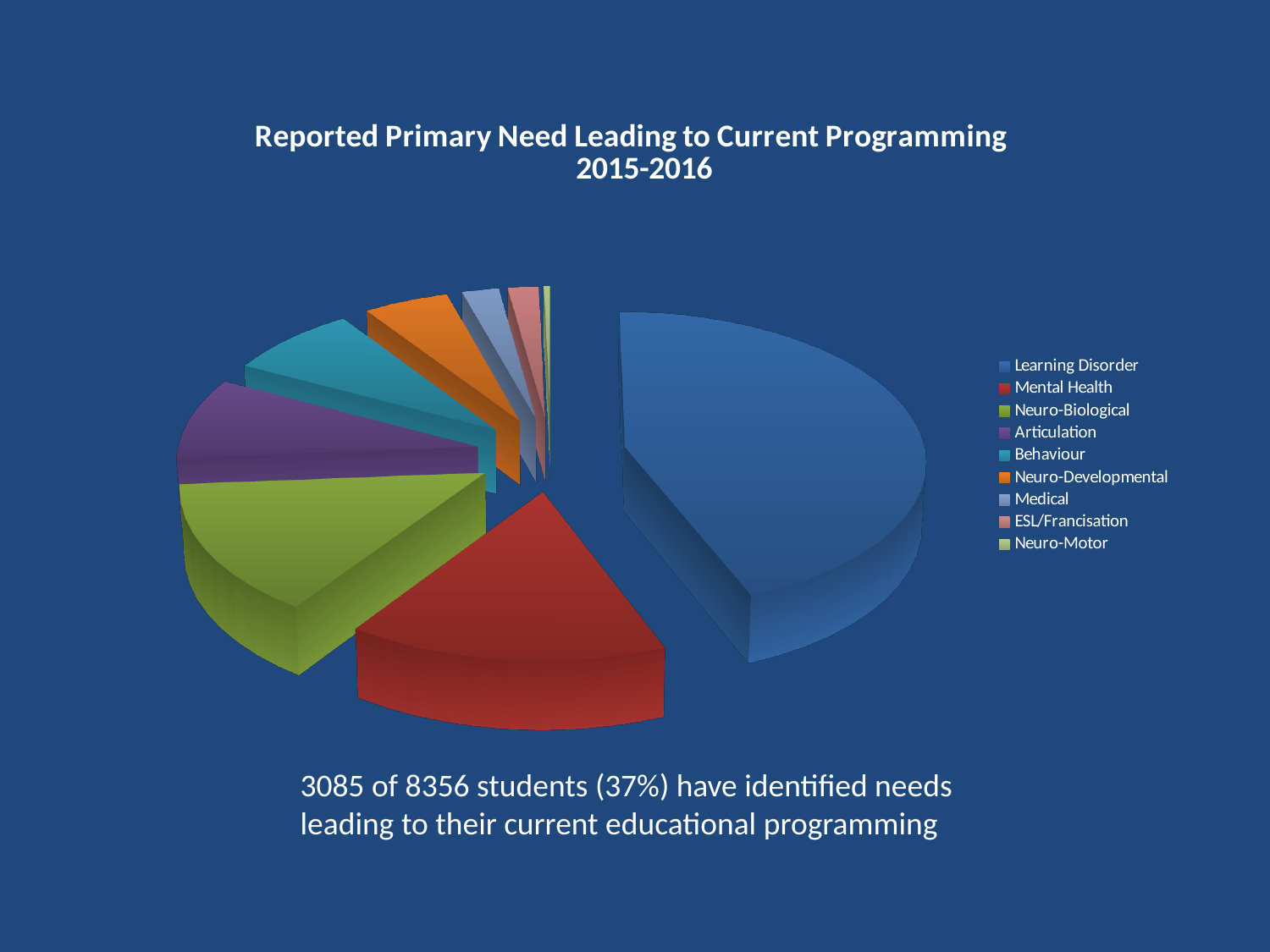
Which category has the smallest slice of the pie? Neuro-Motor Which slice is larger, Learning Disorder or Mental Health? Learning Disorder What kind of chart is shown on the slide? pie chart Which category has the largest slice of the pie? Learning Disorder Which slice is larger, Behaviour or Neuro-Motor? Behaviour Which slice is larger, Neuro-Biological or Medical? Neuro-Biological What colour is the Mental Health slice in the pie chart? red How many categories does the pie chart show? 9 What is the title of the chart? Reported Primary Need Leading to Current Programming 2015-2016